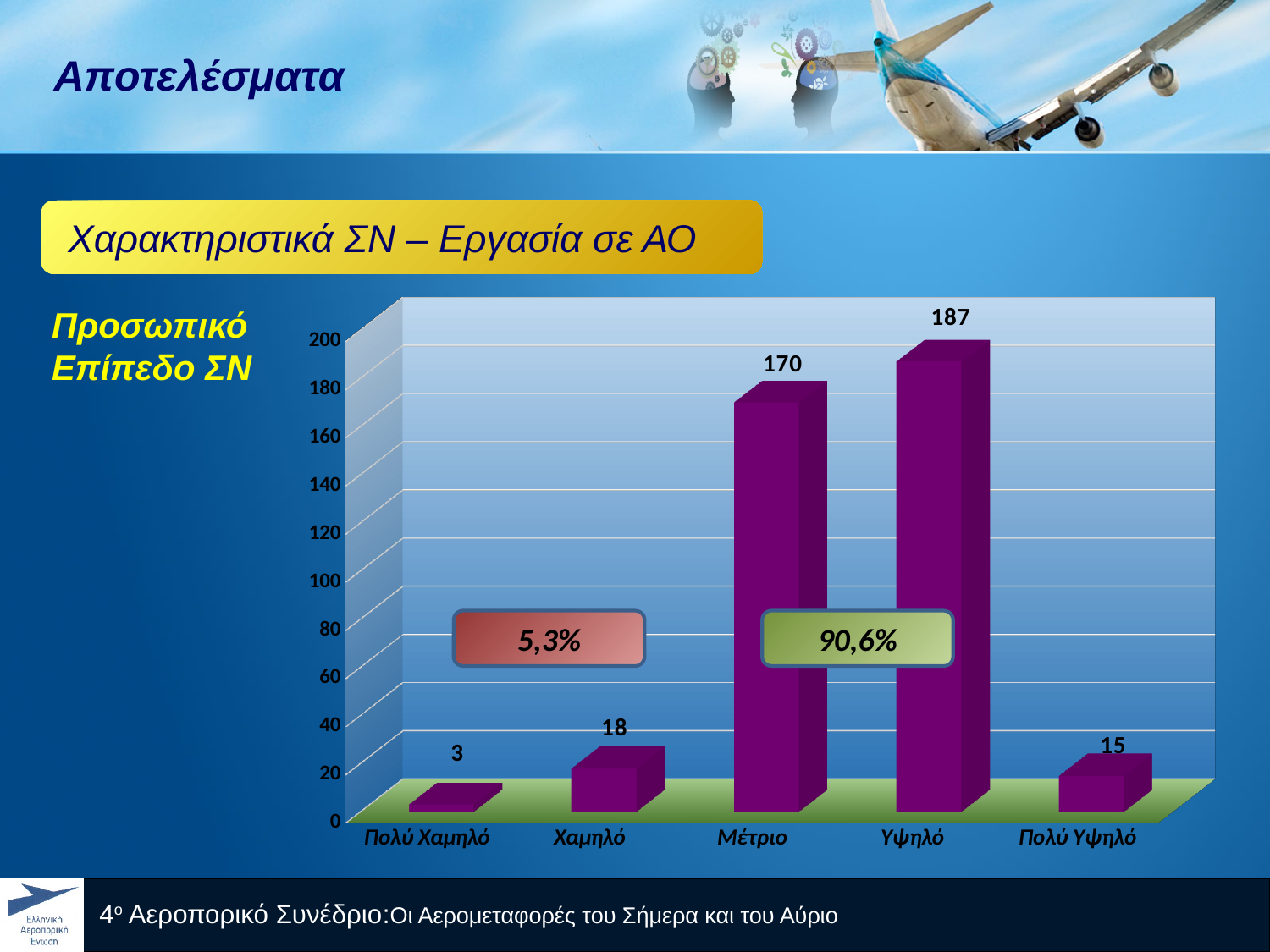
Which category has the highest value? Υψηλό Is the value for Μέτριο greater or less than 160? greater Which category has the lowest value? Πολύ Χαμηλό What is the value for Πολύ Χαμηλό? 3 What is the difference between the values for Υψηλό and Μέτριο? 17 What kind of chart is shown on the slide? bar chart How many categories are shown on the x axis? 5 What is the value for Πολύ Υψηλό? 15 What is the value for Μέτριο? 170 Which is larger, the value for Χαμηλό or the value for Πολύ Υψηλό? Χαμηλό What is the difference between the values for Χαμηλό and Πολύ Υψηλό? 3 What percentage is shown in the green label over the Μέτριο and Υψηλό bars? 90,6%